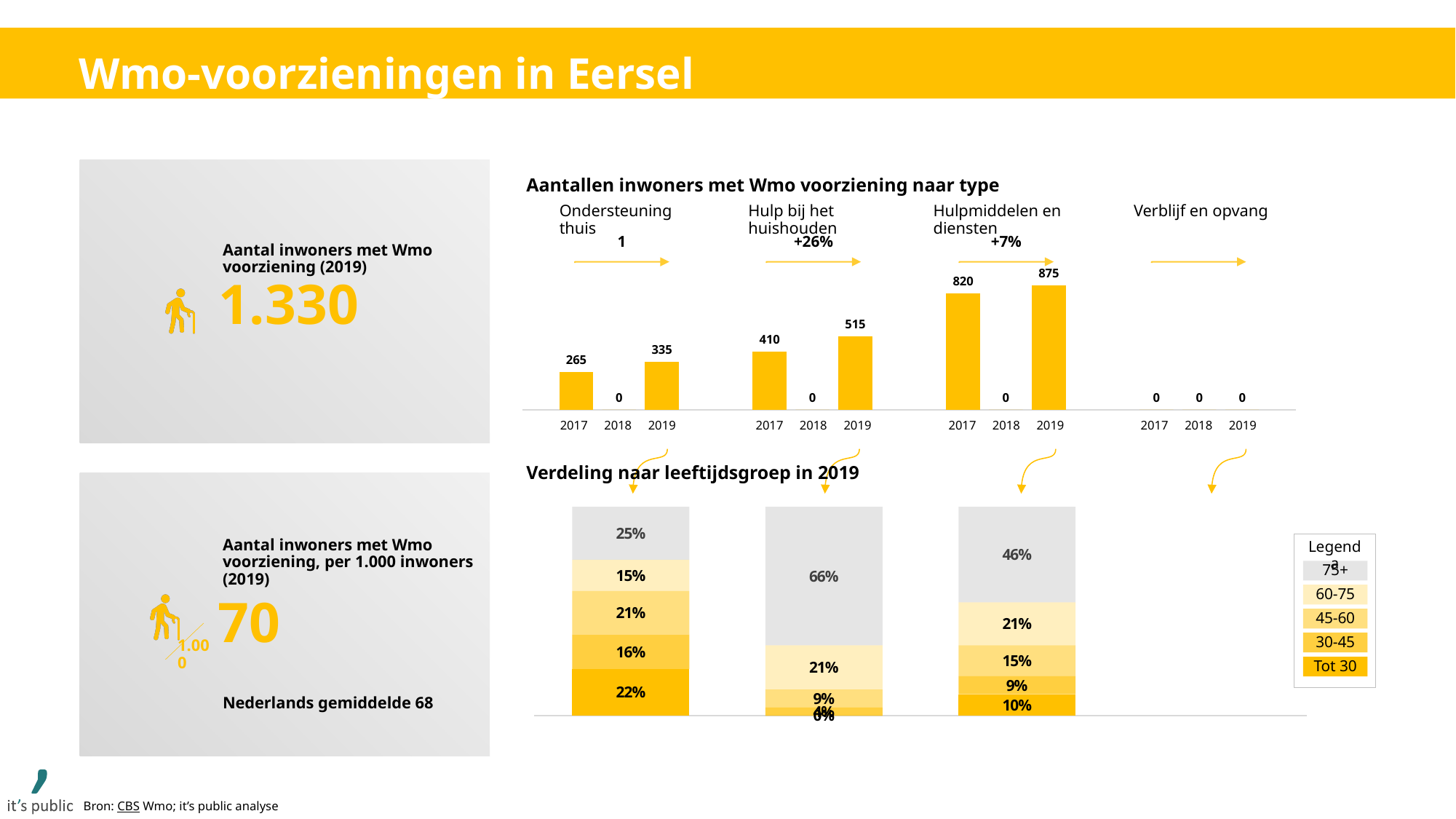
In the chart 'Verdeling naar leeftijdsgroep in 2019', what is the share of the 75+ group for Hulp bij het huishouden? 66% What kind of chart is 'Aantallen inwoners met Wmo voorziening naar type'? bar chart In the chart 'Aantallen inwoners met Wmo voorziening naar type', what percentage change is shown above Hulp bij het huishouden? +26% How many age groups does the legend of the chart 'Verdeling naar leeftijdsgroep in 2019' list? 5 In the chart 'Aantallen inwoners met Wmo voorziening naar type', what is the value for Hulp bij het huishouden in 2017? 410 In the chart 'Verdeling naar leeftijdsgroep in 2019', what is the share of the Tot 30 group for Ondersteuning thuis? 22% In the chart 'Aantallen inwoners met Wmo voorziening naar type', what is the difference between the 2019 and 2017 values for Ondersteuning thuis? 70 In the chart 'Aantallen inwoners met Wmo voorziening naar type', which is larger in 2019: Hulp bij het huishouden or Ondersteuning thuis? Hulp bij het huishouden In the chart 'Aantallen inwoners met Wmo voorziening naar type', which type has the highest value in 2019? Hulpmiddelen en diensten In the chart 'Aantallen inwoners met Wmo voorziening naar type', what is the value for Hulpmiddelen en diensten in 2019? 875 In the chart 'Verdeling naar leeftijdsgroep in 2019', what is the share of the 75+ group for Hulpmiddelen en diensten? 46% In the chart 'Aantallen inwoners met Wmo voorziening naar type', what is the difference between the 2019 and 2017 values for Hulpmiddelen en diensten? 55